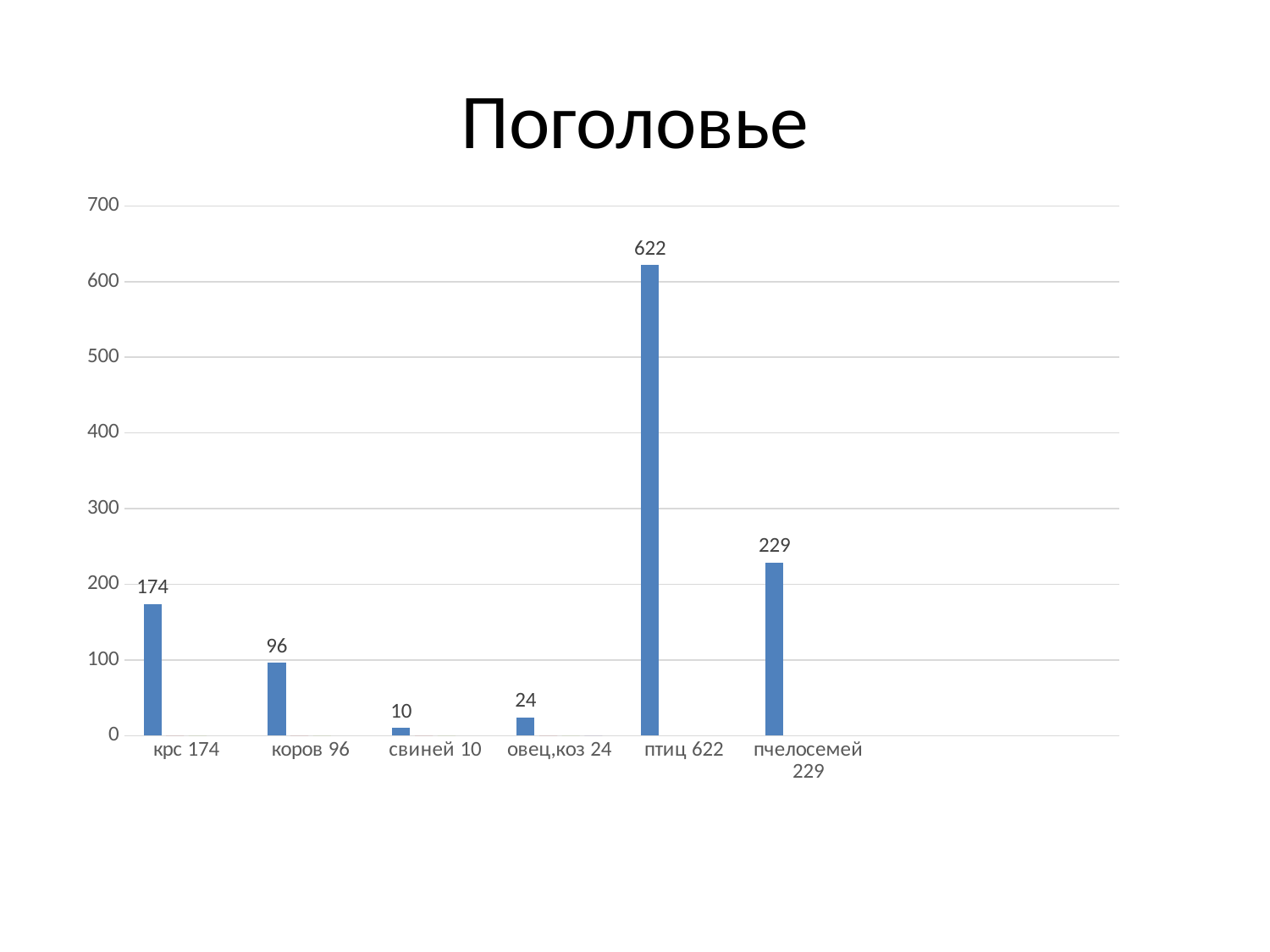
What is the difference between the values for птиц 622 and пчелосемей 229? 393 Which category has the highest value? птиц 622 What is the value for птиц 622? 622 What is the title of the slide? Поголовье Which category has the lowest value? свиней 10 What is the difference between the values for крс 174 and коров 96? 78 What is the value for коров 96? 96 Which is larger, the value for крс 174 or the value for пчелосемей 229? пчелосемей 229 Is the value for птиц 622 greater or less than 600? greater What kind of chart is shown on the slide? bar chart What is the value for пчелосемей 229? 229 How many categories are shown on the chart? 6